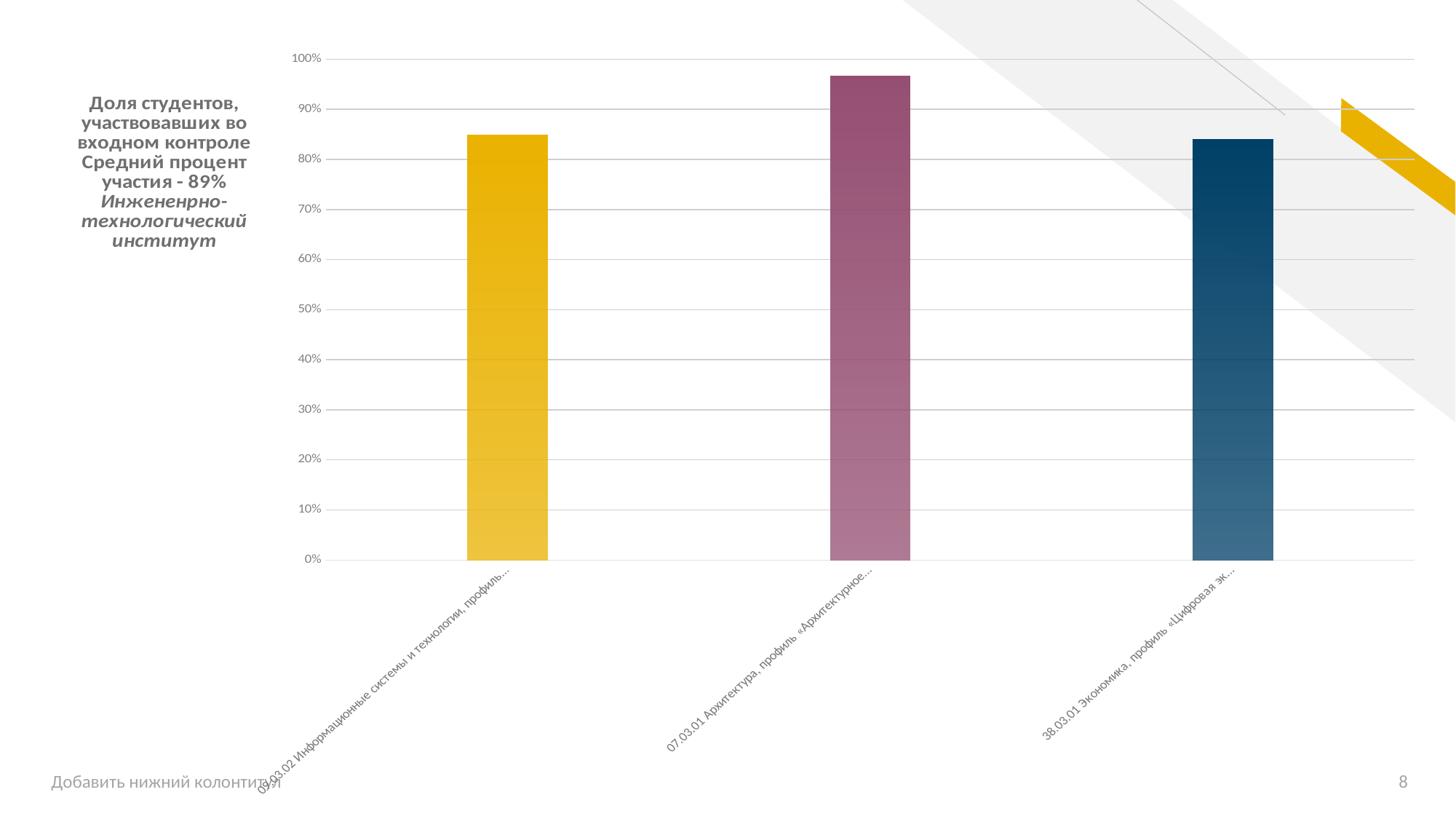
Which category has the highest bar? 07.03.01 Архитектура Is the value for 38.03.01 Экономика greater or less than 90%? less What is the maximum value shown on the vertical axis? 100% Is the value for 09.03.02 Информационные системы и технологии greater or less than 80%? greater Which is larger: the value for 07.03.01 Архитектура or the value for 09.03.02 Информационные системы и технологии? 07.03.01 Архитектура Is the value for 09.03.02 Информационные системы и технологии greater or less than 90%? less How many bars (categories) does the chart show? 3 Which is larger: the value for 07.03.01 Архитектура or the value for 38.03.01 Экономика? 07.03.01 Архитектура What colour is the bar for 38.03.01 Экономика? blue What kind of chart is shown on the slide? bar chart